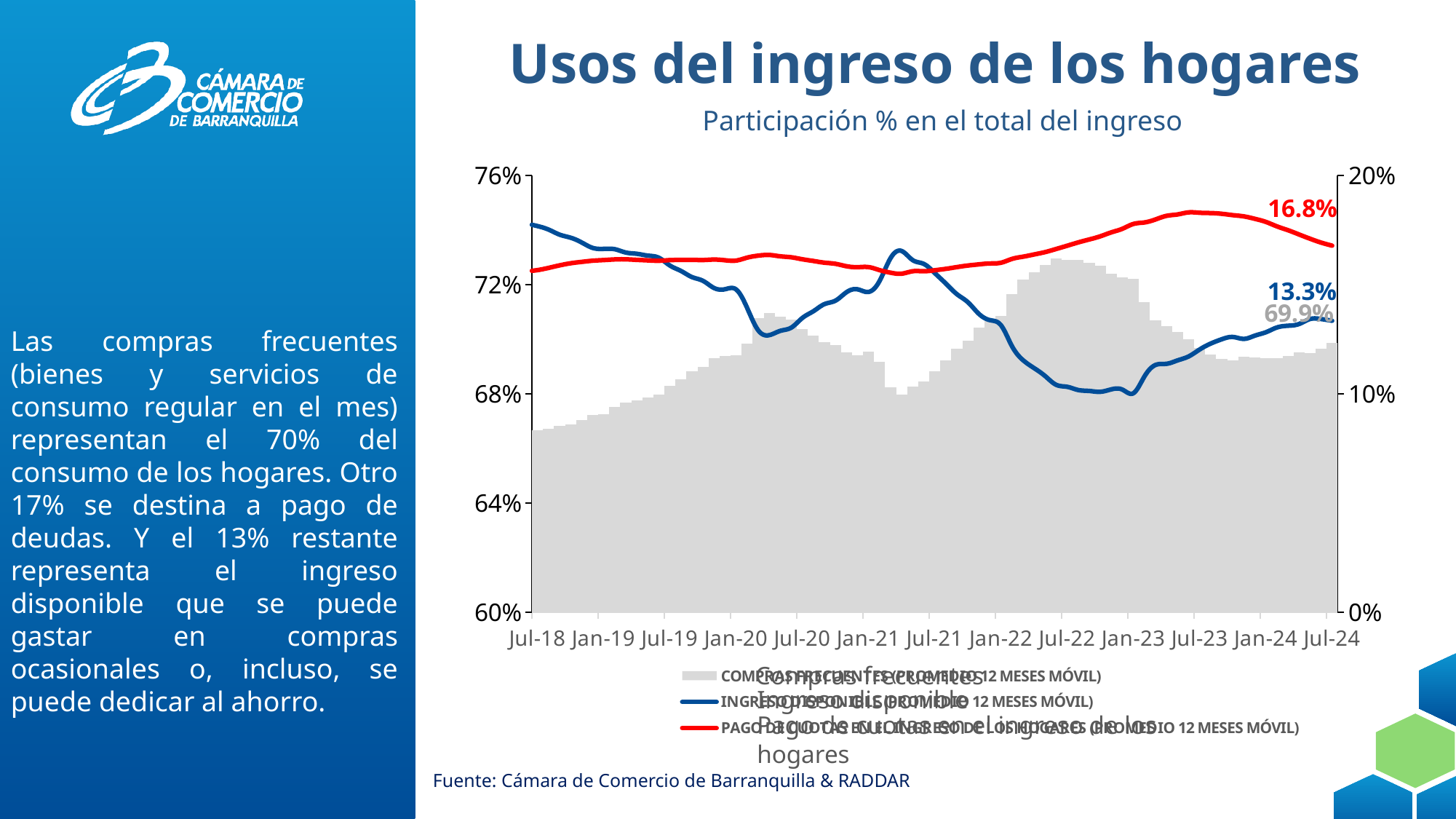
Does the blue line for Ingreso disponible rise or fall overall from Jul-18 to Jul-24? Falls At the end of the series, which is larger: Pago de cuotas (16.8%) or Ingreso disponible (13.3%)? Pago de cuotas Is the value of Ingreso disponible (blue line, right axis) at Jul-18 greater or less than 12%? greater What is the latest labelled value for Pago de cuotas en el ingreso de los hogares (red line)? 16.8% What is the difference between the final labelled values of Pago de cuotas (16.8%) and Ingreso disponible (13.3%)? 3.5 percentage points Does the red line for Pago de cuotas rise or fall overall from Jul-18 to Jul-24? Rises What is the title of the chart? Usos del ingreso de los hogares What kind of chart is shown on the slide? Combined bar and line chart What is the latest labelled value for Ingreso disponible (blue line)? 13.3% How many series does the chart's legend list? 3 What is the latest labelled value for Compras frecuentes (grey bars)? 69.9% Is the value of Compras frecuentes (grey bars, left axis) at Jul-18 greater or less than 68%? less